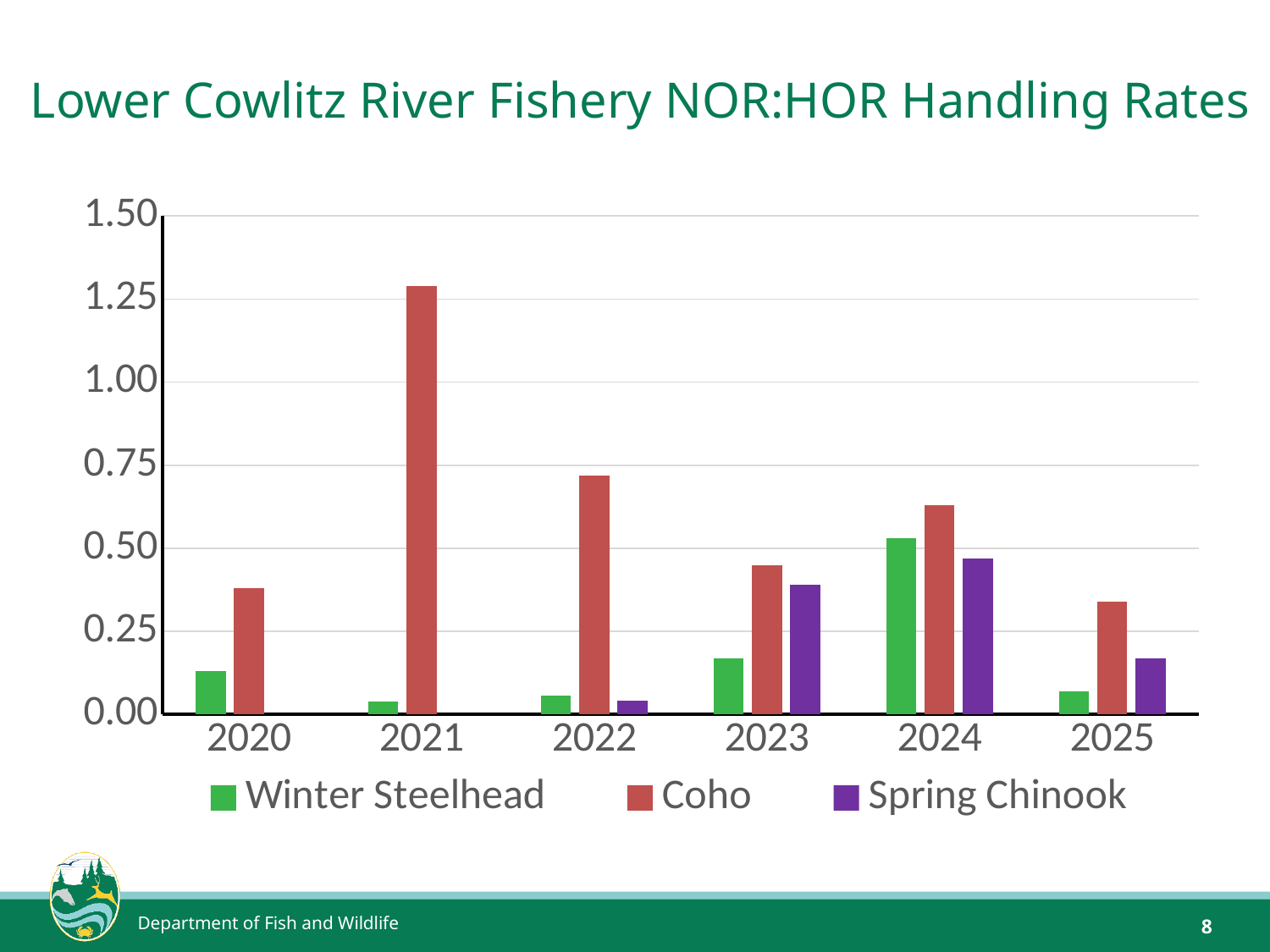
Is the Coho value for 2021 greater or less than 1.00? greater In 2024, which is larger: the Winter Steelhead value or the Coho value? Coho Is the Winter Steelhead value for 2024 greater or less than 0.25? greater What kind of chart is shown on the slide? bar chart Does the Coho handling rate rise or fall from 2021 to 2022? fall In which year is the Coho handling rate highest? 2021 Is the Coho value for 2022 greater or less than 0.75? less How many series does the legend list? 3 What is the title of the chart? Lower Cowlitz River Fishery NOR:HOR Handling Rates In which year is the Spring Chinook handling rate highest? 2024 In which year is the Winter Steelhead handling rate highest? 2024 How many years are shown on the x axis? 6